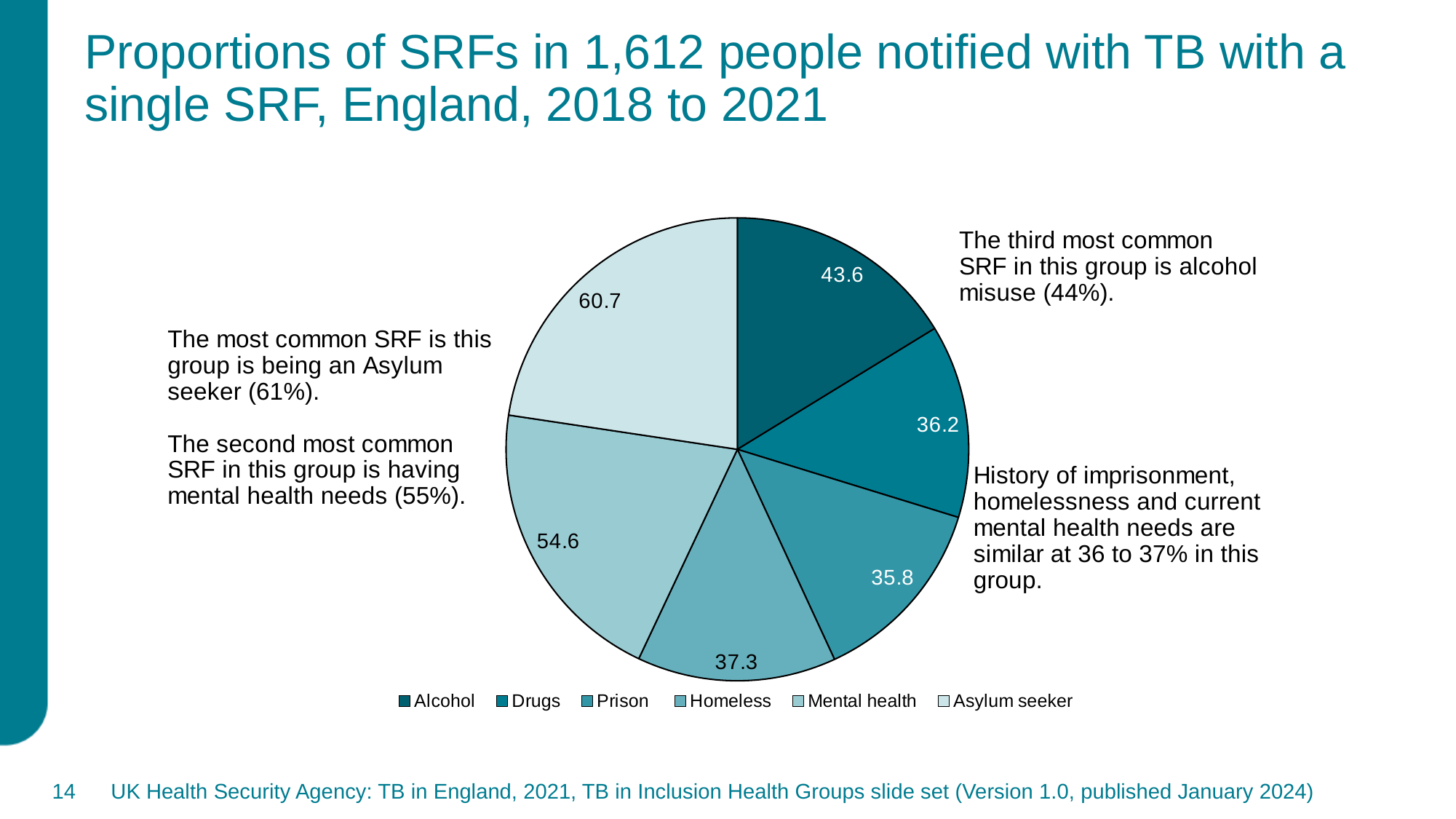
How many categories does the legend list? 6 What is the value shown for the Homeless slice? 37.3 What is the value shown for the Prison slice? 35.8 What is the value shown for the Asylum seeker slice? 60.7 Which is larger, the Alcohol slice or the Homeless slice? Alcohol Which category has the largest slice in the pie chart? Asylum seeker What is the value shown for the Alcohol slice? 43.6 What is the difference between the Alcohol value and the Drugs value? 7.4 What is the difference between the Asylum seeker value and the Mental health value? 6.1 What is the value shown for the Mental health slice? 54.6 Which category has the smallest slice in the pie chart? Prison What type of chart is shown on the slide? pie chart